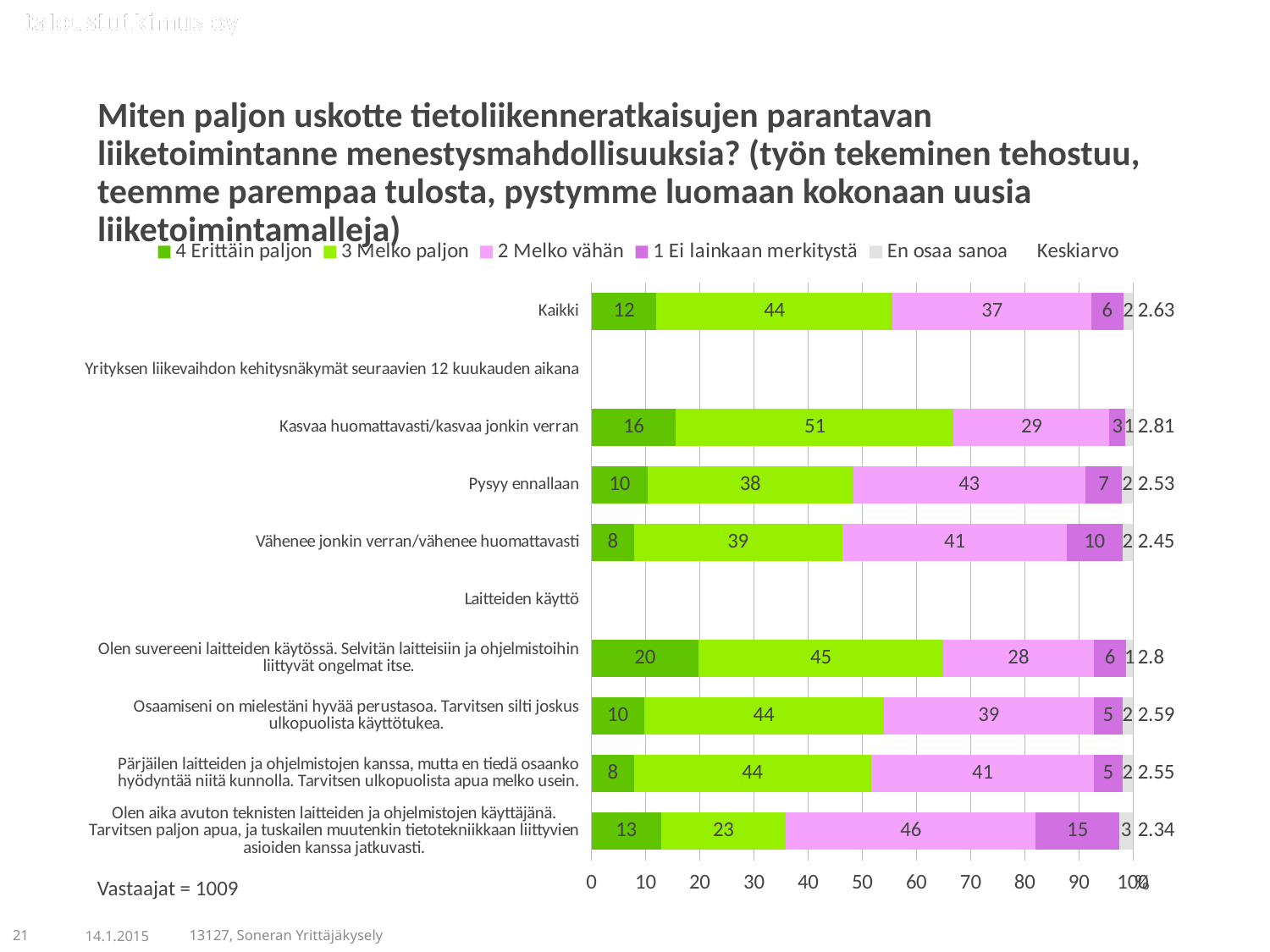
Which bar has the lowest Keskiarvo (mean) value? Olen aika avuton teknisten laitteiden ja ohjelmistojen käyttäjänä. Tarvitsen paljon apua, ja tuskailen muutenkin tietotekniikkaan liittyvien asioiden kanssa jatkuvasti. What is the difference between the '3 Melko paljon' values for 'Kasvaa huomattavasti/kasvaa jonkin verran' and 'Pysyy ennallaan'? 13 What is the Keskiarvo (mean) shown for 'Kasvaa huomattavasti/kasvaa jonkin verran'? 2.81 Which bar has the highest value for '4 Erittäin paljon'? Olen suvereeni laitteiden käytössä. Selvitän laitteisiin ja ohjelmistoihin liittyvät ongelmat itse. What is the value of '3 Melko paljon' for the 'Kaikki' bar? 44 How many bars with data are plotted in the chart? 8 What is the value of '1 Ei lainkaan merkitystä' for the bar 'Olen aika avuton teknisten laitteiden ja ohjelmistojen käyttäjänä...'? 15 What kind of chart is shown on the slide? stacked bar chart Which is larger: the '2 Melko vähän' value for 'Vähenee jonkin verran/vähenee huomattavasti' or for 'Kaikki'? Vähenee jonkin verran/vähenee huomattavasti What is the combined value of '4 Erittäin paljon' and '3 Melko paljon' for the 'Kaikki' bar? 56 What is the value of '2 Melko vähän' for 'Pysyy ennallaan'? 43 What is the number of respondents (Vastaajat) stated on the slide? 1009